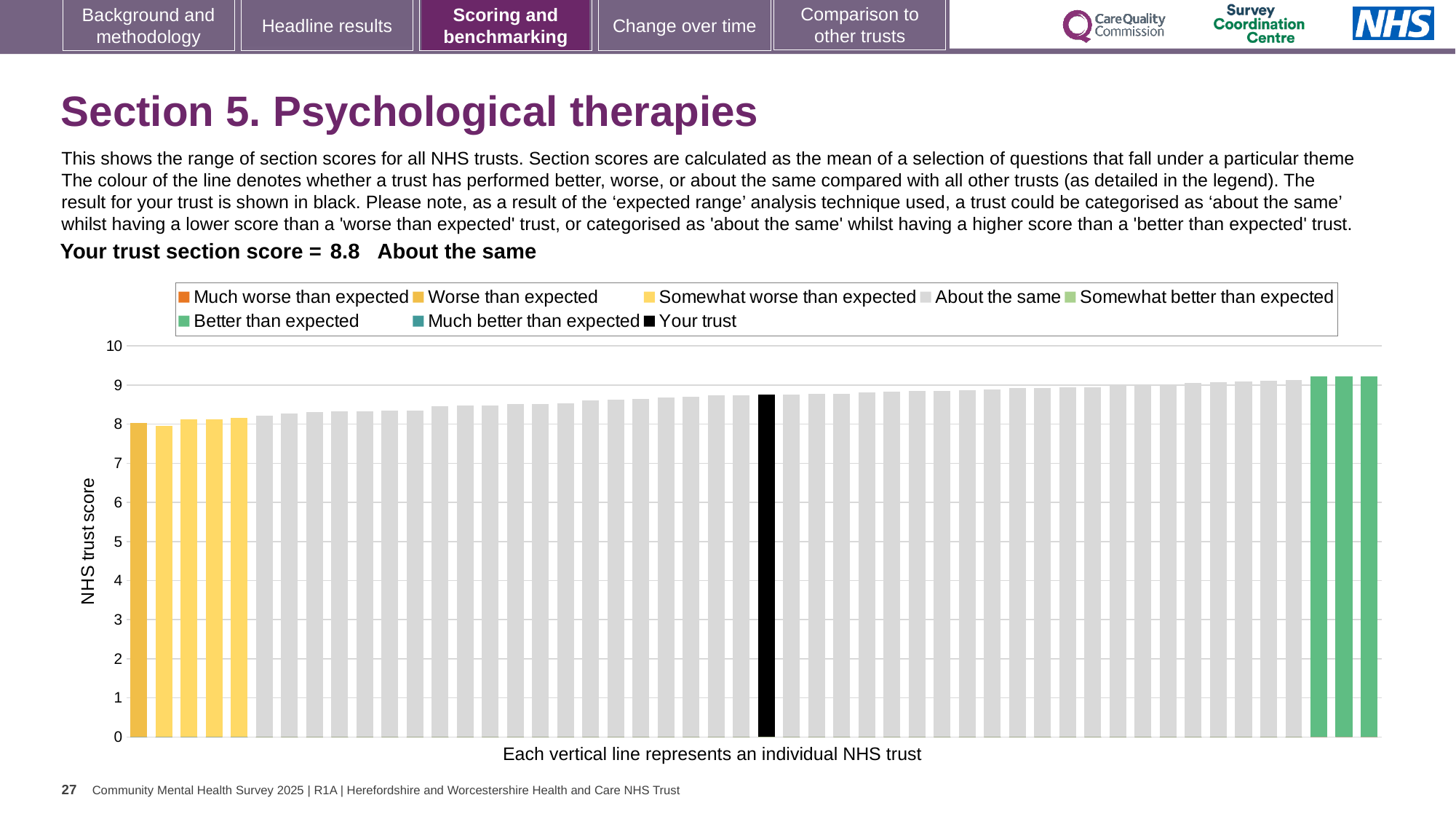
Do the bar values rise or fall from left to right along the x axis? rise What kind of chart is shown on the slide? bar chart Is the value for the lowest bar in the chart greater or less than 9? less Is the value for the highest bar in the chart greater or less than 9? greater How many bars are coloured green (better than expected)? 3 How many entries does the chart legend list? 8 What colour is the bar representing your trust? black What is the label on the vertical axis of the chart? NHS trust score Is the value for your trust greater or less than 8? greater How is your trust's section score categorised compared with other trusts? About the same What is the section score for your trust shown on the slide? 8.8